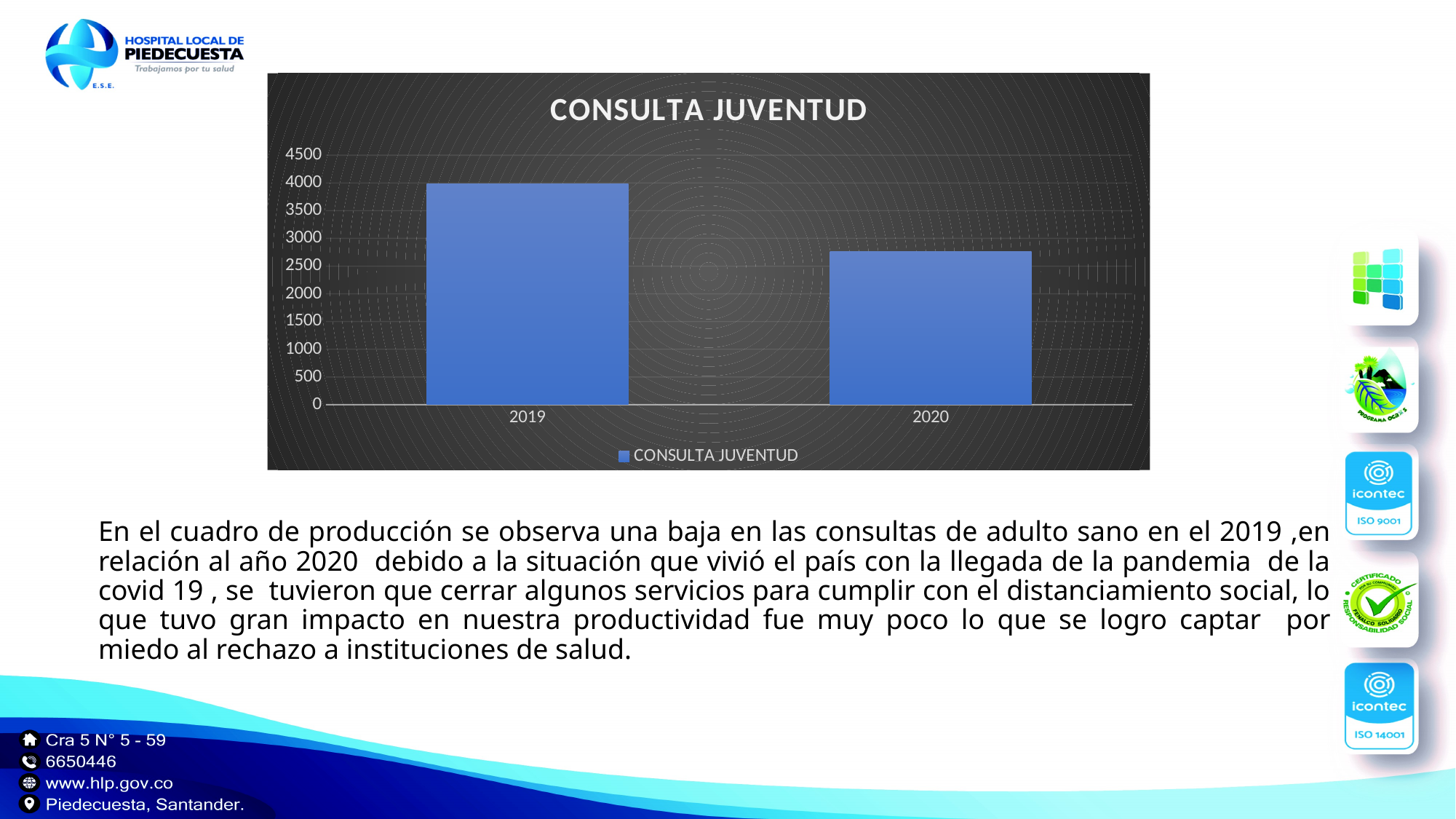
Which year has the highest value in the chart? 2019 How many series does the chart legend list? 1 Is the value for 2020 greater or less than 3000? less Which is larger, the value for 2019 or the value for 2020? 2019 Is the value for 2019 greater or less than 3500? greater What is the name of the series shown in the chart legend? CONSULTA JUVENTUD What is the title of the chart? CONSULTA JUVENTUD Is the value for 2020 greater or less than 2500? greater How many categories are shown on the x axis of the chart? 2 Do the values rise or fall from 2019 to 2020? fall What kind of chart is shown on the slide? bar chart Which year has the lowest value in the chart? 2020